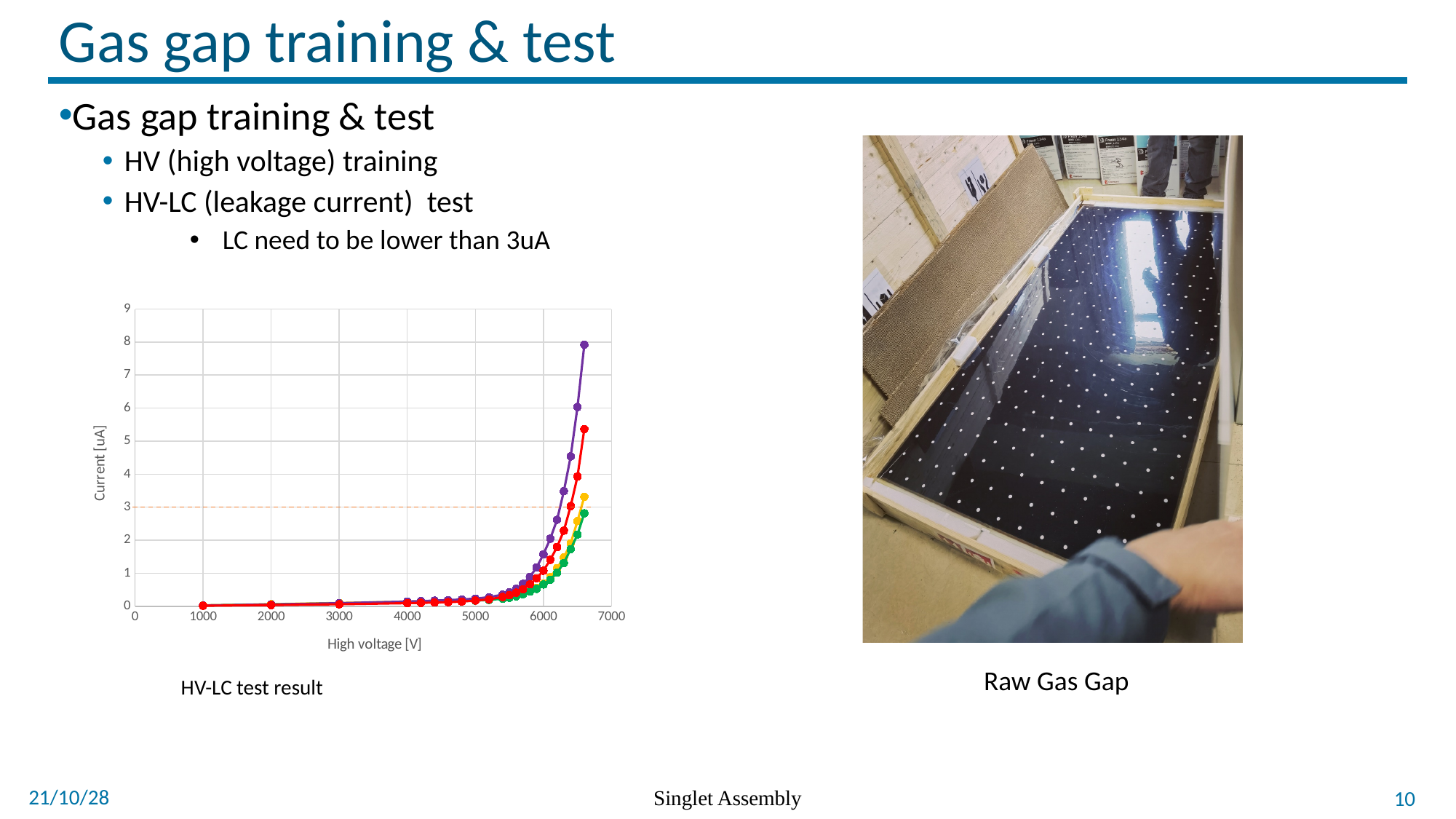
In the HV-LC test result chart, is the highest value of the purple series greater or less than 7? greater What is the maximum value shown on the y axis of the HV-LC test result chart? 9 In the HV-LC test result chart, at the highest voltage, is the purple series or the green series larger? purple In the HV-LC test result chart, is the highest value of the red series greater or less than 5? greater What is the title of the x axis of the HV-LC test result chart? High voltage [V] What kind of chart is the HV-LC test result chart? line chart In the HV-LC test result chart, which coloured series has the lowest current at the highest voltage? green In the HV-LC test result chart, does the current rise or fall as the high voltage increases? rise In the HV-LC test result chart, is the current at 3000 V greater or less than 1? less What is the title of the y axis of the HV-LC test result chart? Current [uA] In the HV-LC test result chart, which coloured series reaches the highest current at the highest voltage? purple